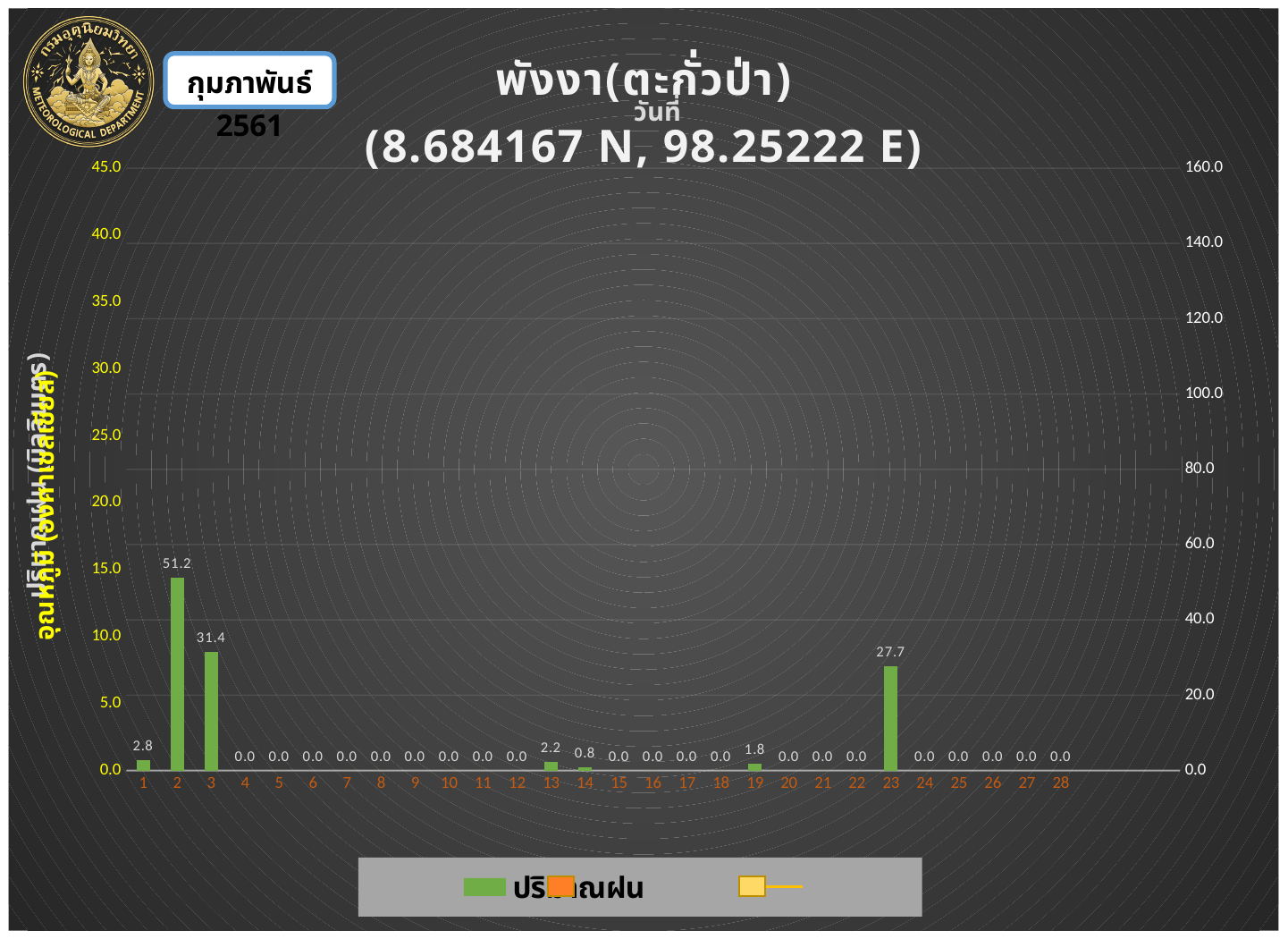
What is the rainfall value for day 23? 27.7 What coordinates are given in the chart title? 8.684167 N, 98.25222 E What type of chart is shown on the slide? bar chart How many series does the legend list? 3 What is the rainfall value for day 13? 2.2 How many days (categories) are shown on the x axis? 28 What is the rainfall value for day 1? 2.8 Which is larger, the rainfall value for day 3 or for day 23? day 3 What is the rainfall value for day 2? 51.2 What is the difference between the rainfall values for day 3 and day 23? 3.7 What is the difference between the rainfall values for day 2 and day 3? 19.8 Which day has the highest rainfall value? 2